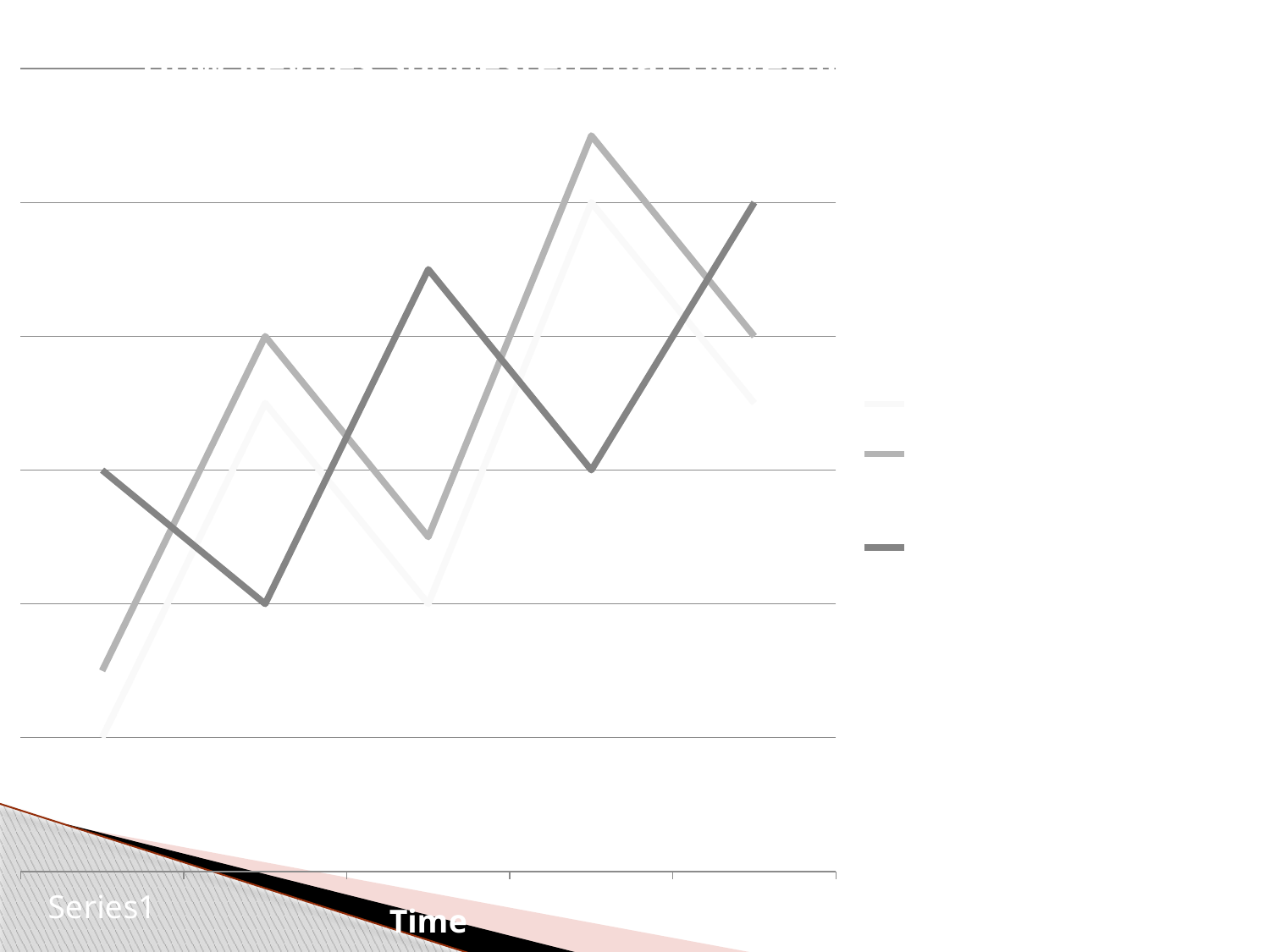
How many data points does each line in the chart have? 5 Does the light gray line end higher or lower than where it starts? higher What is the title of the horizontal axis? Time What kind of chart is shown on the slide? line chart How many series does the legend list? 3 Does the dark gray line end higher or lower than where it starts? higher